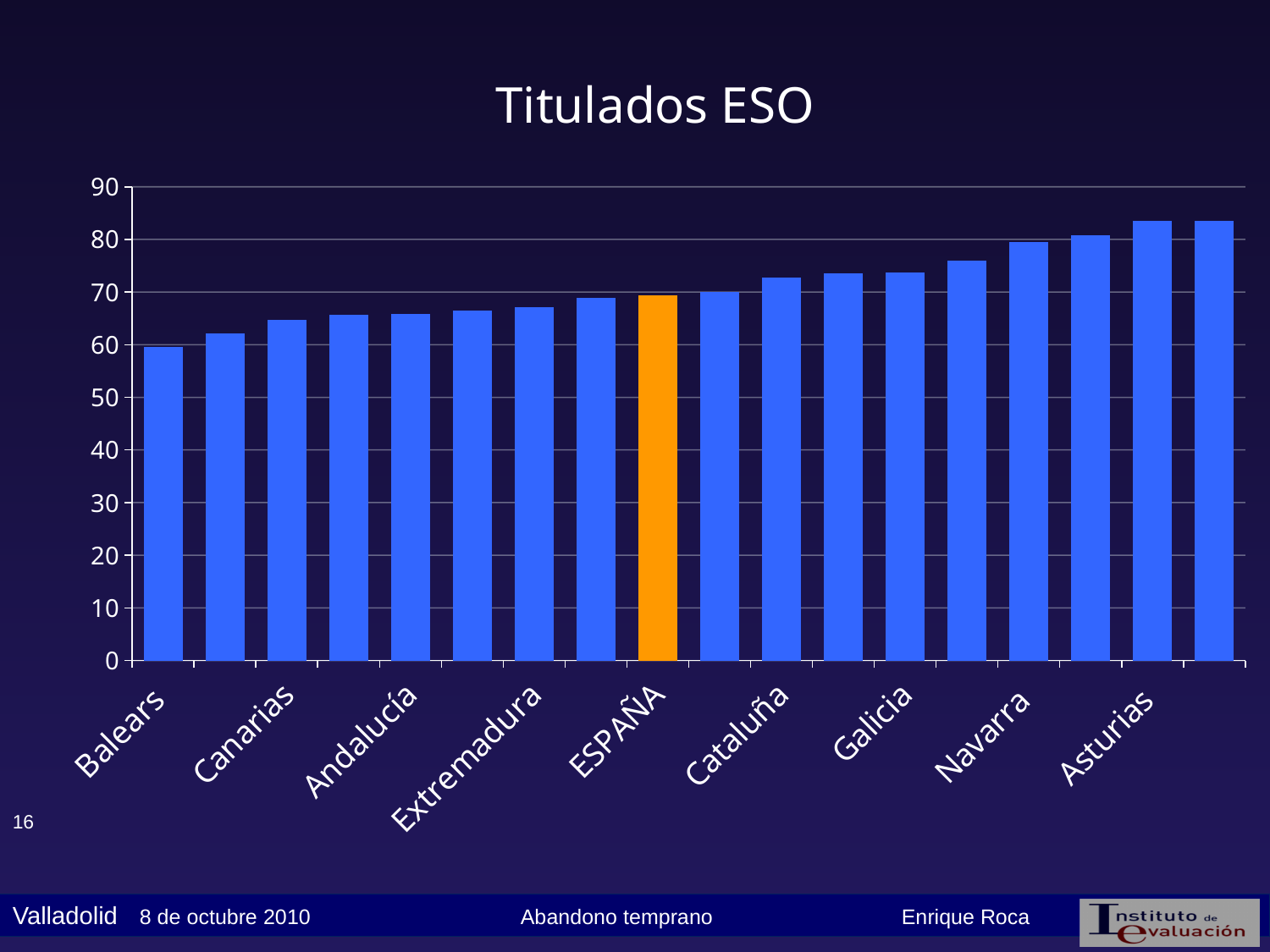
Which labelled category has the lowest value? Balears Is the value for Cataluña greater or less than 70? greater Which has a higher value, Navarra or Cataluña? Navarra How many bars are plotted in the chart? 18 Is the value for Extremadura greater or less than 70? less Do the values generally rise or fall from left to right along the x axis? rise Which bar is highlighted in a different colour (orange) from the others? ESPAÑA Is the value for Asturias greater or less than 80? greater What is the title of the chart? Titulados ESO What kind of chart is shown on the slide? bar chart Which has a higher value, Asturias or Balears? Asturias